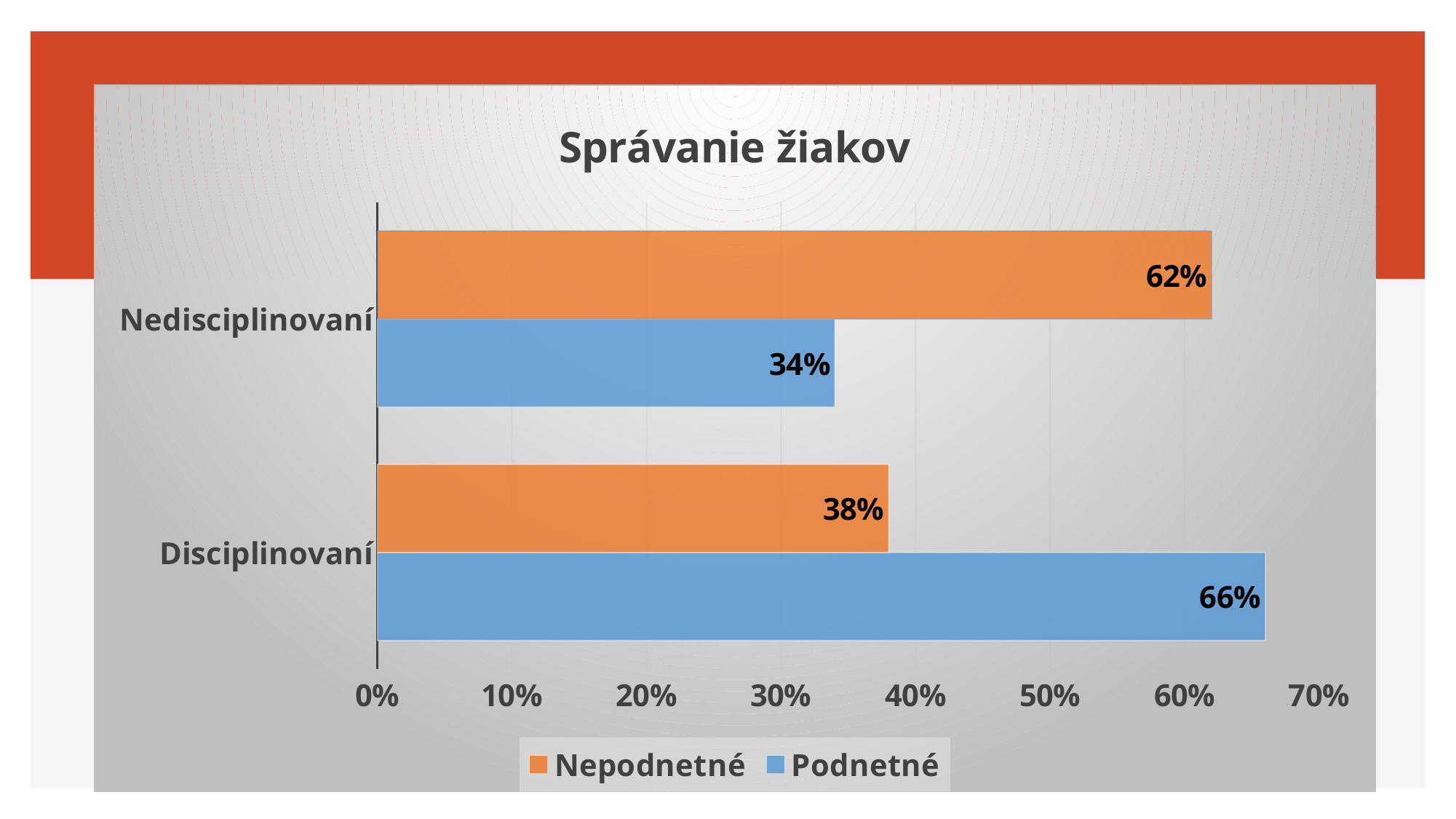
What is the value for Nepodnetné in the Disciplinovaní category? 38% What is the difference between the Nepodnetné and Podnetné values for Nedisciplinovaní? 28% How many categories are shown on the chart? 2 What is the value for Podnetné in the Nedisciplinovaní category? 34% What type of chart is shown on the slide? Bar chart Is the Podnetné value for Disciplinovaní greater or less than 60%? greater Which category has the highest Podnetné value? Disciplinovaní Which category has the lowest Nepodnetné value? Disciplinovaní What is the value for Nepodnetné in the Nedisciplinovaní category? 62% How many series does the legend list? 2 Which is larger for Disciplinovaní: Nepodnetné or Podnetné? Podnetné What is the value for Podnetné in the Disciplinovaní category? 66%